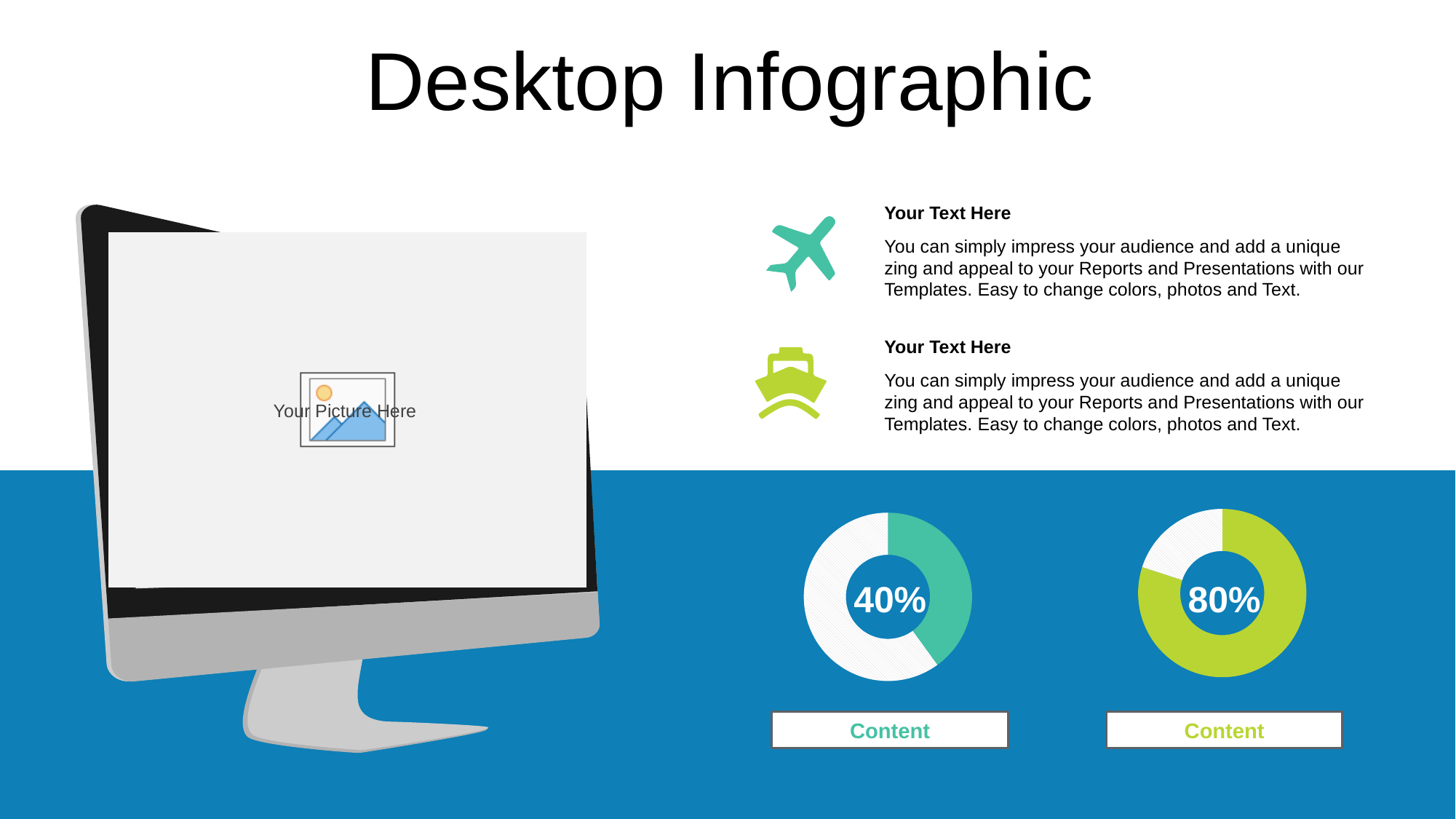
What label appears in the box below each donut chart? Content Is the value shown in the right donut chart greater or less than 50%? greater What percentage is shown in the centre of the right donut chart? 80% In the right donut chart, what share of the ring is filled in green? 80% What is the difference between the percentage in the right donut chart and the percentage in the left donut chart? 40% Which donut chart shows the larger percentage, the left one or the right one? the right one What percentage is shown in the centre of the left donut chart? 40% In the left donut chart, what share of the ring is filled in teal? 40% What colour is the filled portion of the right donut chart? green Is the value shown in the left donut chart greater or less than 50%? less What kind of chart is used to display the 40% and 80% values? donut chart How many donut charts are shown on the slide? 2